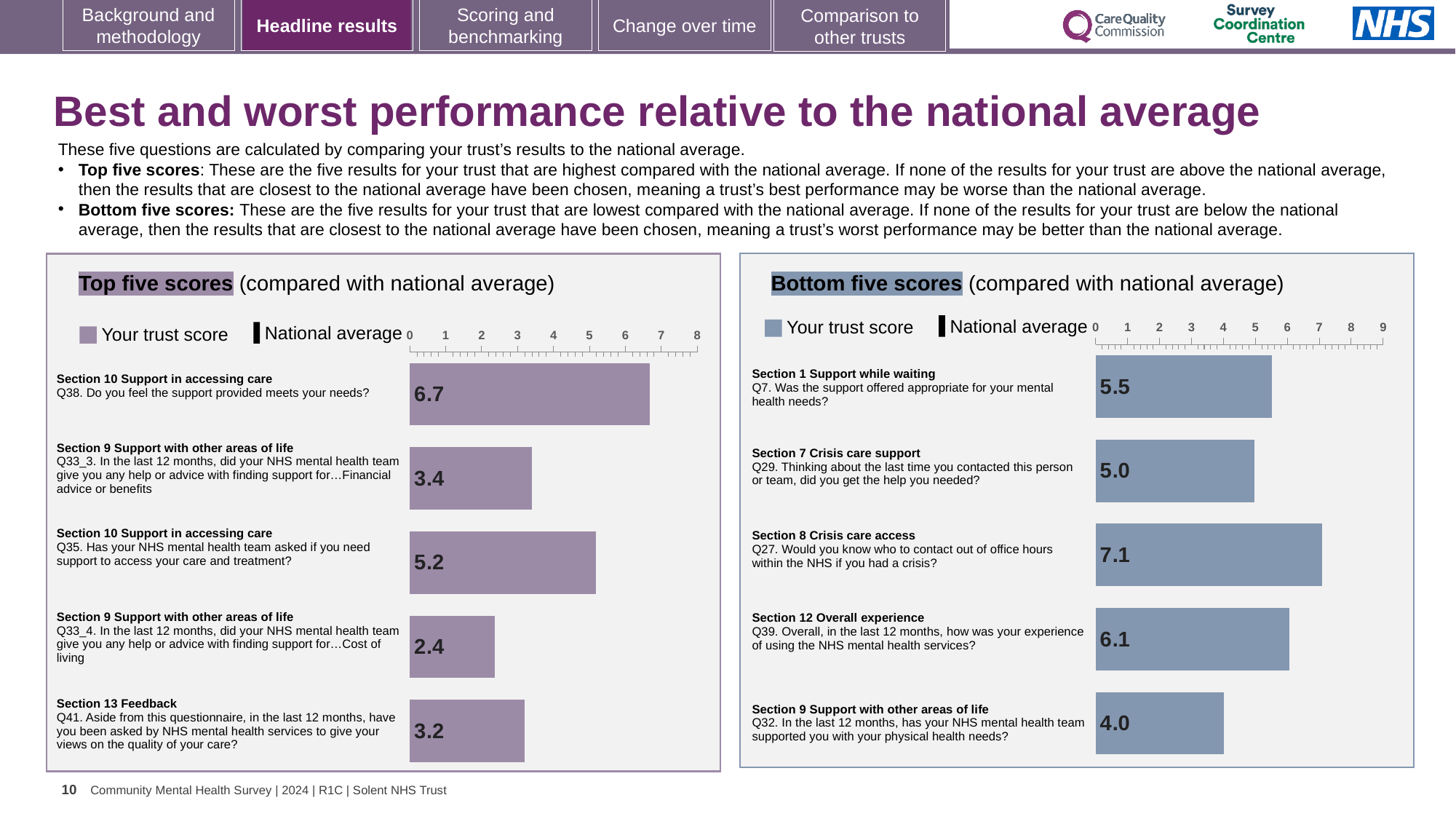
In the Top five scores chart, which question has the highest trust score? Q38 In the Top five scores chart, what is the trust score for Q33_4 (help or advice with finding support for cost of living)? 2.4 In the Bottom five scores chart, what is the trust score for Q32 (supported you with your physical health needs)? 4.0 What is the highest tick value on the axis of the Bottom five scores chart? 9 How many questions are shown in the Top five scores chart? 5 In the Bottom five scores chart, which question has the lowest trust score? Q32 In the Top five scores chart, what is the trust score for Q38 (Do you feel the support provided meets your needs?)? 6.7 In the Bottom five scores chart, what is the difference between the trust scores for Q27 and Q29? 2.1 What type of chart is the Bottom five scores chart? Bar chart In the Bottom five scores chart, which has the larger trust score, Q7 or Q39? Q39 In the Top five scores chart, what is the difference between the trust scores for Q38 and Q35? 1.5 In the Bottom five scores chart, what is the trust score for Q27 (Would you know who to contact out of office hours within the NHS if you had a crisis?)? 7.1